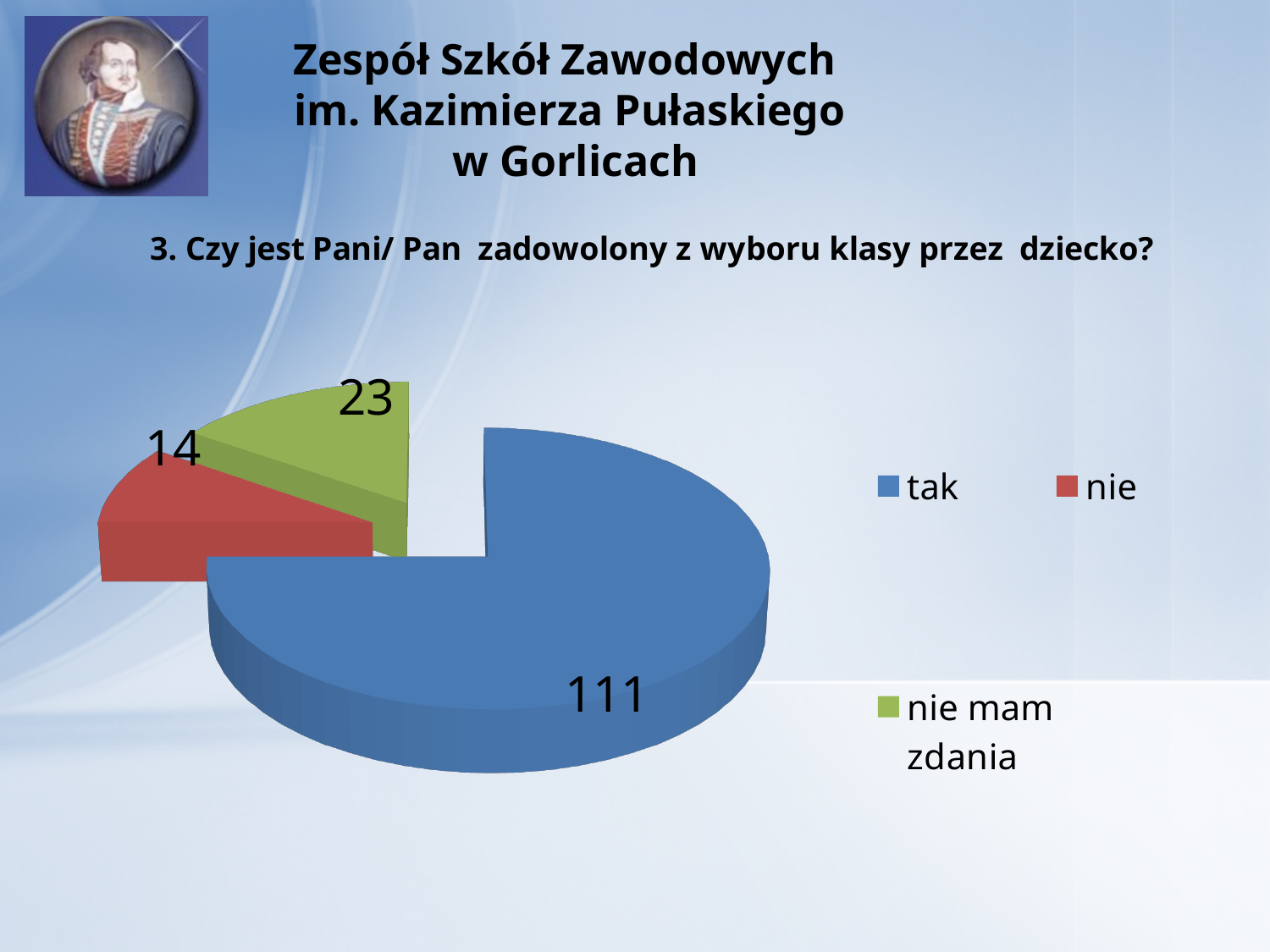
What share of the pie does the "tak" slice represent? 75% What is the difference between the values for "nie mam zdania" and "nie"? 9 What is the value for "nie mam zdania" in the pie chart? 23 Which category has the largest slice in the pie chart? tak Which is larger, the value for "nie" or the value for "nie mam zdania"? nie mam zdania What is the difference between the values for "tak" and "nie mam zdania"? 88 How many categories does the pie chart show? 3 What is the value for "nie" in the pie chart? 14 What kind of chart is shown on the slide? pie chart Which category has the smallest slice in the pie chart? nie What colour is the "nie" slice in the pie chart? red What is the value for "tak" in the pie chart? 111